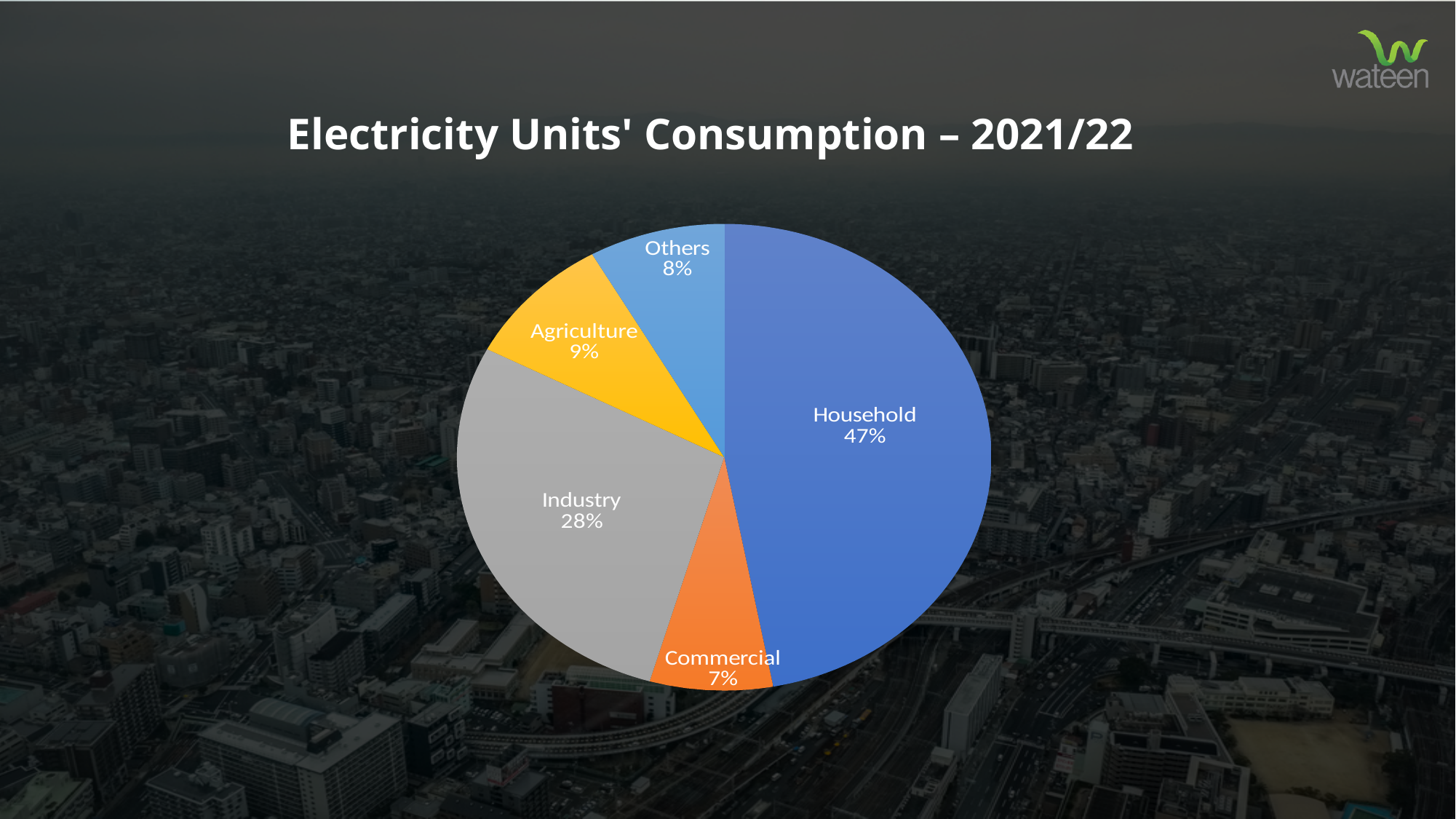
How many percentage points larger is the Household share than the Industry share? 19 Which has a larger share, Others or Commercial? Others How many categories are shown in the pie chart? 5 What type of chart is shown on the slide? Pie chart What is the share for Commercial? 7% What share of electricity consumption is attributed to Household? 47% Which category has the smallest share of electricity consumption? Commercial What percentage of electricity consumption does Industry account for? 28% What is the difference in percentage points between Agriculture and Others? 1 What is the share for Agriculture? 9% Which category has the largest share of electricity consumption? Household What is the title of the chart? Electricity Units' Consumption – 2021/22